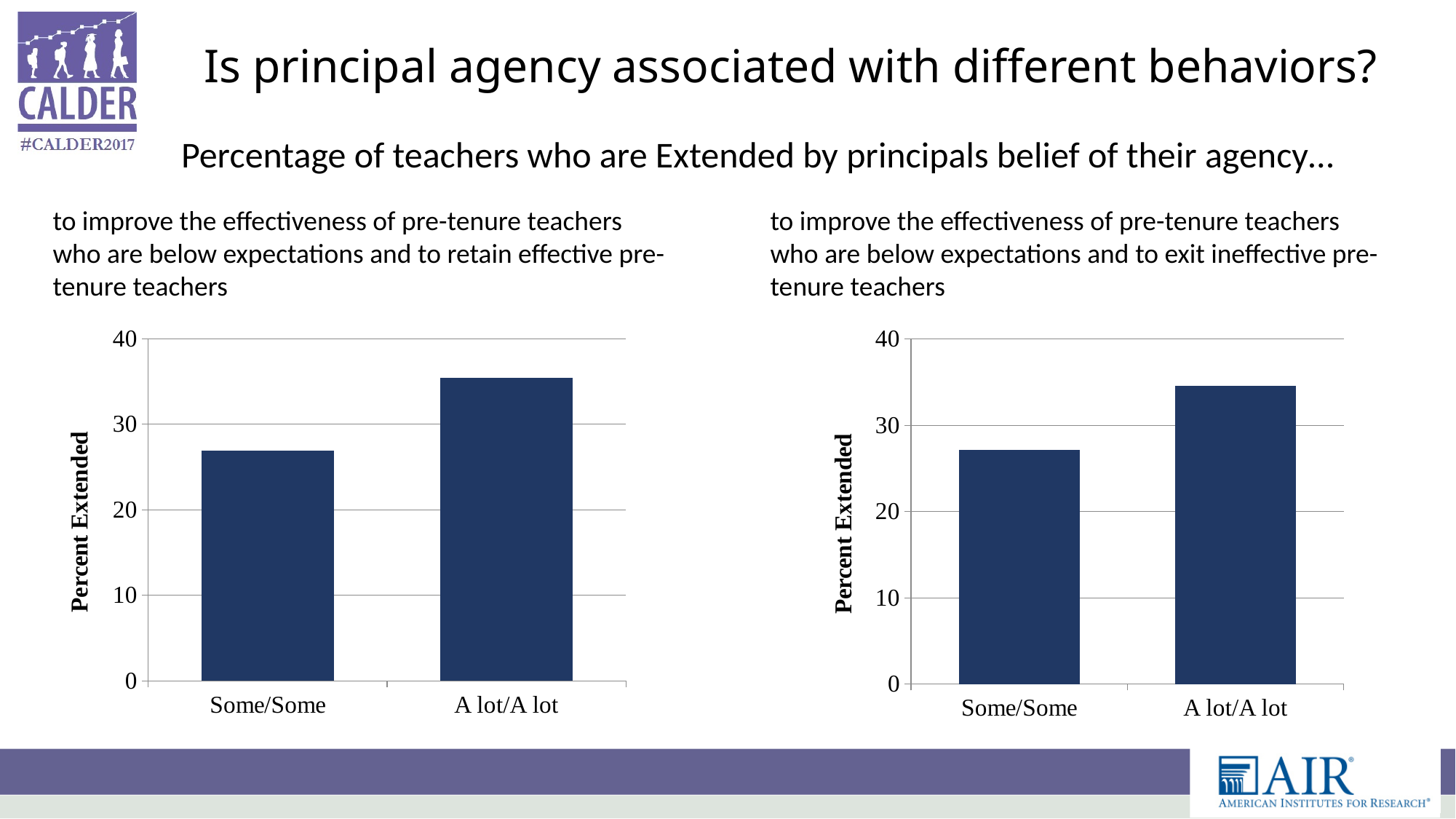
In the right chart, which is larger, the value for Some/Some or the value for A lot/A lot? A lot/A lot In the right chart, is the value for Some/Some greater or less than 20? greater In the left chart, what kind of chart is shown? bar chart In the right chart, is the value for A lot/A lot greater or less than 40? less In the right chart, what is the label on the y axis? Percent Extended In the left chart, which category has the highest percent extended? A lot/A lot In the right chart, do the values rise or fall from Some/Some to A lot/A lot? rise In the left chart, is the value for Some/Some greater or less than 30? less In the left chart, which category has the lowest percent extended? Some/Some In the right chart, which category has the highest percent extended? A lot/A lot In the left chart, how many categories are shown on the x axis? 2